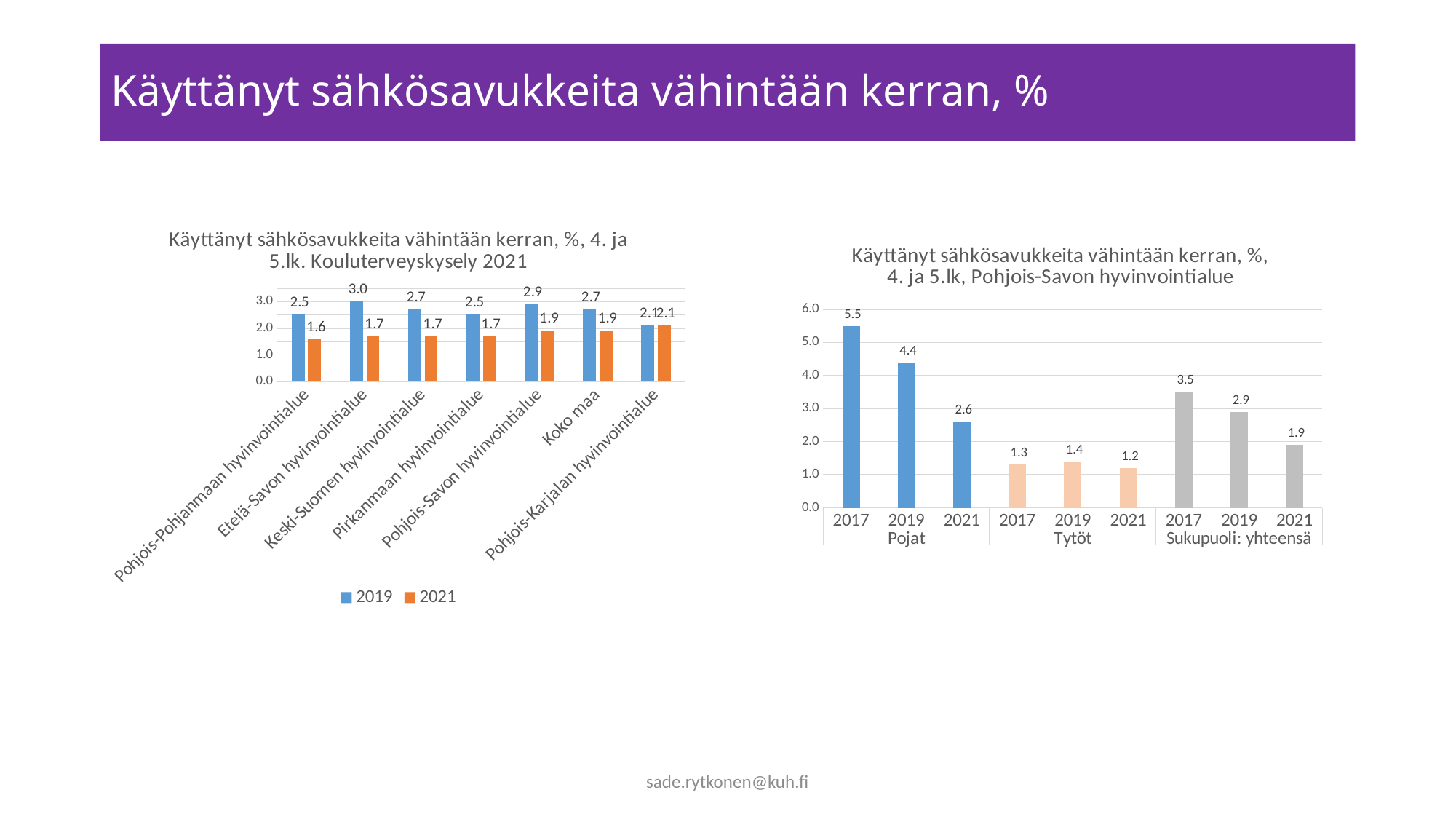
What kind of chart is the right chart (Pohjois-Savon hyvinvointialue)? bar chart In the right chart (Pohjois-Savon hyvinvointialue), do the values for Pojat rise or fall from 2017 to 2021? fall In the left chart (Kouluterveyskysely 2021), what is the 2019 value for Etelä-Savon hyvinvointialue? 3.0 In the left chart (Kouluterveyskysely 2021), what is the 2021 value for Pohjois-Savon hyvinvointialue? 1.9 In the right chart (Pohjois-Savon hyvinvointialue), what is the value for Tytöt in 2021? 1.2 In the left chart (Kouluterveyskysely 2021), what is the difference between the 2019 and 2021 values for Koko maa? 0.8 In the left chart (Kouluterveyskysely 2021), which region has the highest 2019 value? Etelä-Savon hyvinvointialue In the right chart (Pohjois-Savon hyvinvointialue), what is the difference between the Sukupuoli: yhteensä values for 2017 and 2021? 1.6 In the left chart (Kouluterveyskysely 2021), which category has the lowest 2021 value? Pohjois-Pohjanmaan hyvinvointialue In the left chart (Kouluterveyskysely 2021), how many regions/categories are shown on the x axis? 7 In the left chart (Kouluterveyskysely 2021), how many series does the legend list? 2 In the right chart (Pohjois-Savon hyvinvointialue), what is the value for Pojat in 2017? 5.5